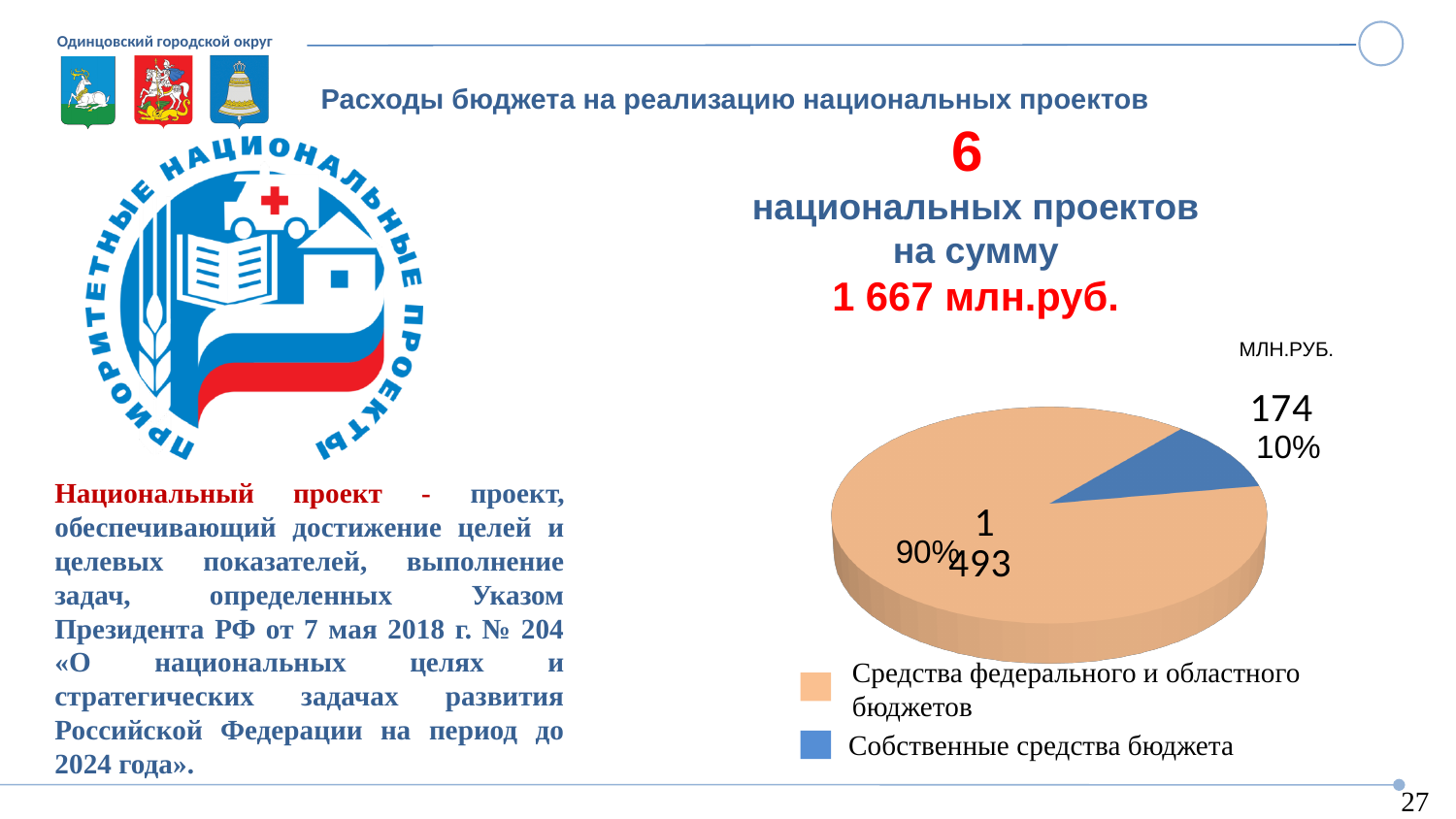
What share of the pie does "Собственные средства бюджета" represent? 10% What is the value for "Собственные средства бюджета" in the pie chart? 174 How many slices does the pie chart have? 2 What unit is indicated for the values in the pie chart? млн.руб. What kind of chart is shown on the slide? pie chart Which slice of the pie chart is the largest? Средства федерального и областного бюджетов What is the difference between the values for "Средства федерального и областного бюджетов" and "Собственные средства бюджета"? 1 319 What share of the pie does "Средства федерального и областного бюджетов" represent? 90% Which colour represents "Собственные средства бюджета" in the pie chart? blue How many entries does the legend of the pie chart list? 2 What is the value for "Средства федерального и областного бюджетов" in the pie chart? 1 493 Which slice of the pie chart is the smallest? Собственные средства бюджета